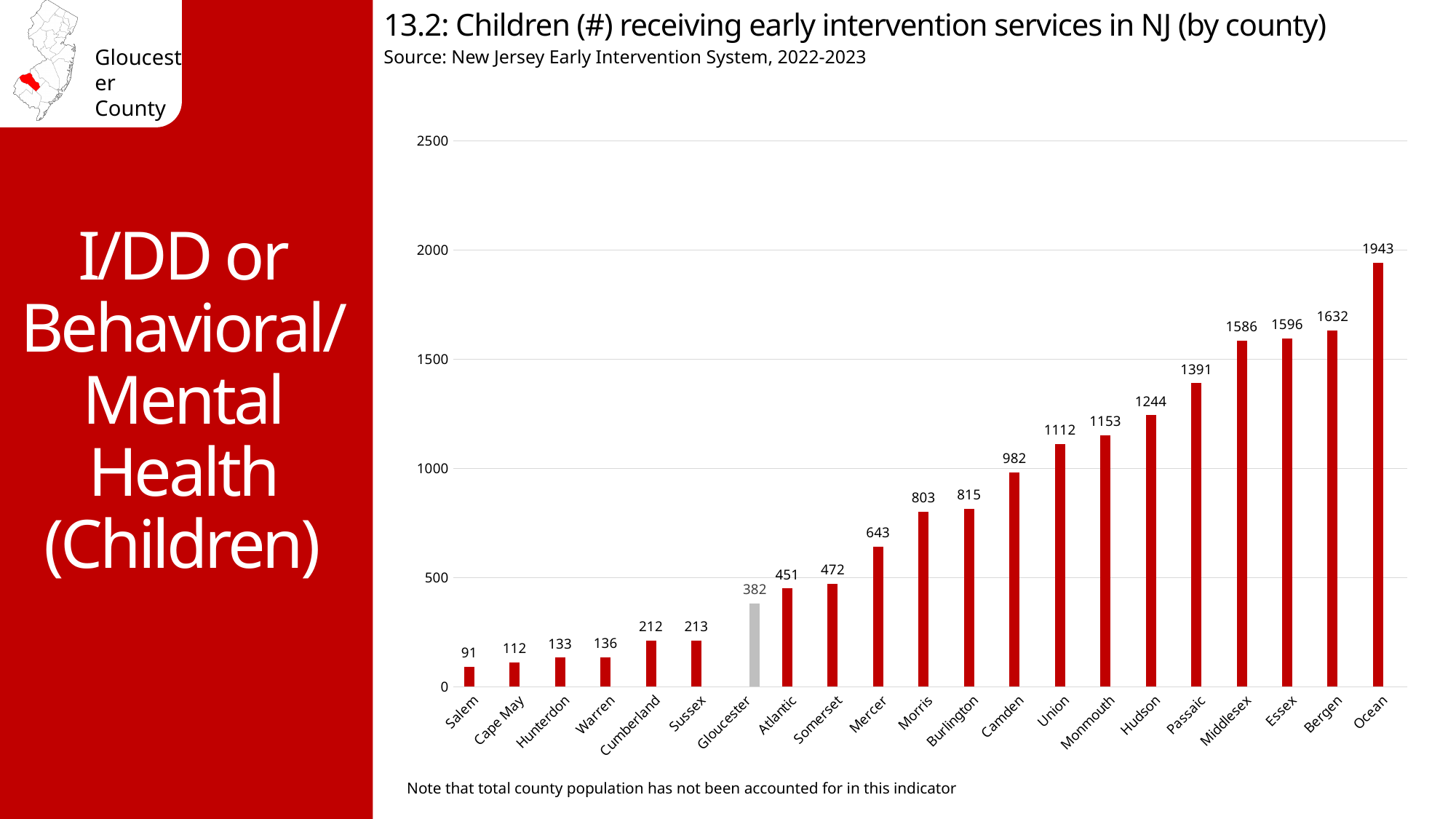
Which county has the lowest number of children receiving early intervention services? Salem Which has a larger value, Mercer or Morris? Morris How many children are receiving early intervention services in Gloucester County? 382 How many counties are shown on the chart? 21 Is the value for Passaic greater or less than 1500? less Do the values rise or fall moving from left to right along the x axis? rise What is the difference between the values for Gloucester and Sussex? 169 What is the value shown for Camden? 982 Which county's bar is coloured grey instead of red? Gloucester Which county has the highest number of children receiving early intervention services? Ocean What is the difference between the values for Ocean and Bergen? 311 What kind of chart is shown on the slide? bar chart